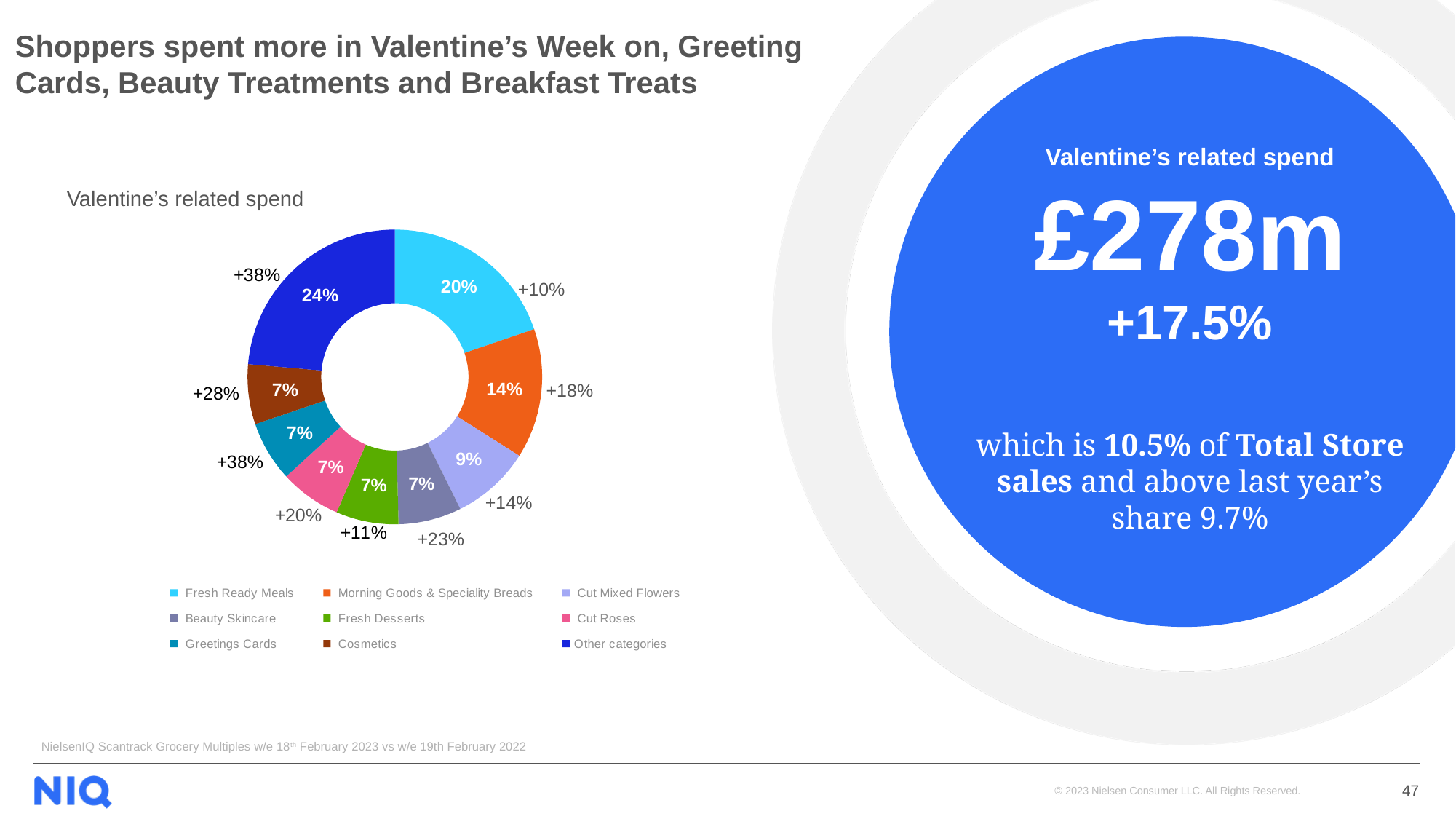
Which has the larger share of Valentine's related spend: Fresh Ready Meals or Morning Goods & Speciality Breads? Fresh Ready Meals What share of Valentine's related spend does Cut Mixed Flowers account for? 9% What share of Valentine's related spend does Other categories account for? 24% What type of chart is shown on the slide? Doughnut (pie) chart What share of Valentine's related spend does Morning Goods & Speciality Breads account for? 14% What share of Valentine's related spend does Fresh Ready Meals account for? 20% What is the difference in share between Other categories (24%) and Fresh Ready Meals (20%)? 4 percentage points What growth figure is shown next to the Other categories segment of the doughnut chart? +38% What growth figure is shown next to the Fresh Ready Meals segment of the doughnut chart? +10% Which category has the largest share of Valentine's related spend in the doughnut chart? Other categories What is the title of the chart on the left of the slide? Valentine's related spend How many categories does the doughnut chart's legend list? 9